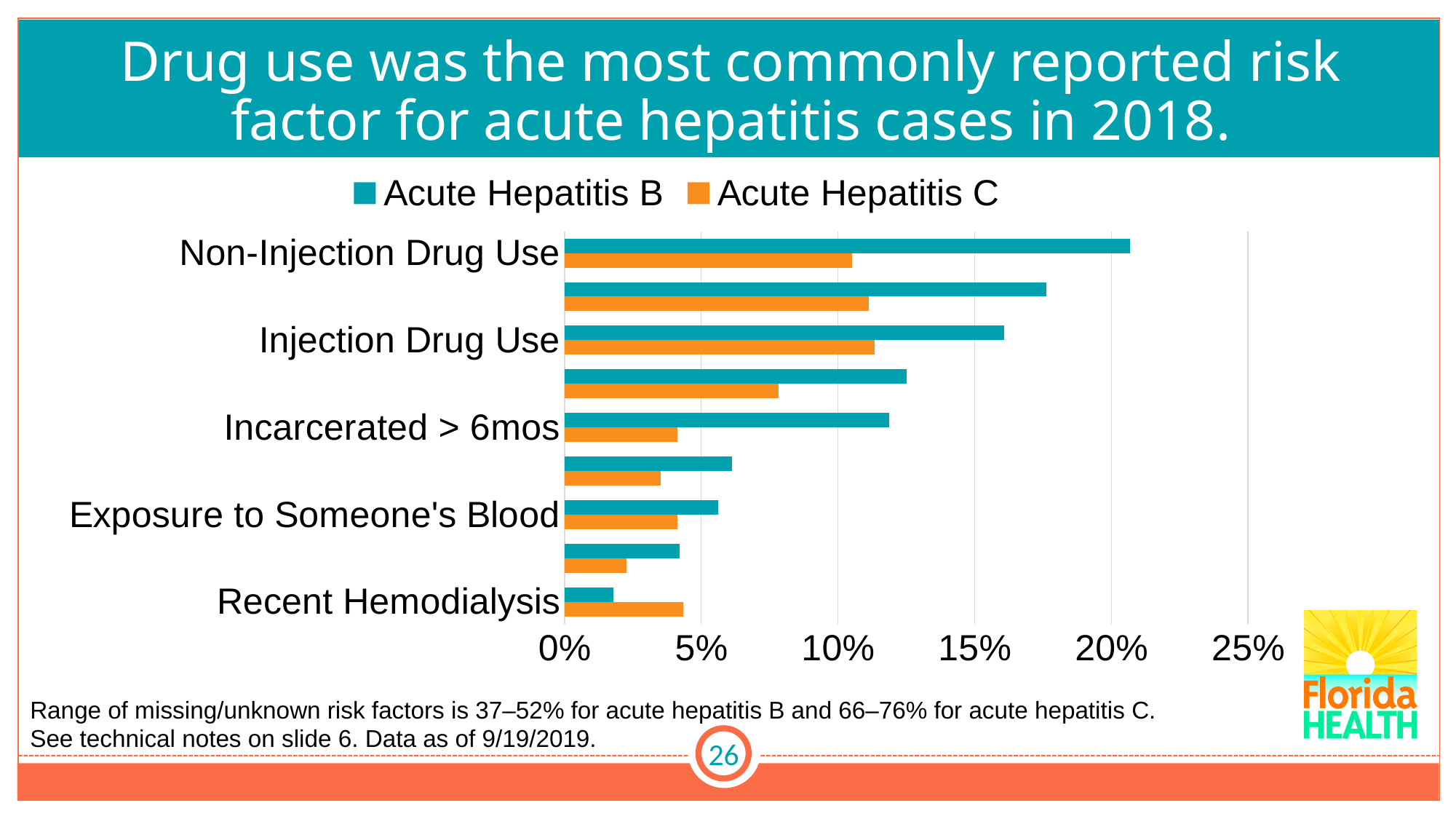
Among the labeled risk factors, which has the lowest value for Acute Hepatitis B? Recent Hemodialysis What kind of chart is shown on the slide? bar chart Is the Acute Hepatitis B value for Injection Drug Use greater or less than 15%? greater Which two series are listed in the legend? Acute Hepatitis B and Acute Hepatitis C Among the labeled risk factors, which has the highest value for Acute Hepatitis B? Non-Injection Drug Use Is the Acute Hepatitis B value for Recent Hemodialysis greater or less than 5%? less For Recent Hemodialysis, which series has the larger value, Acute Hepatitis B or Acute Hepatitis C? Acute Hepatitis C For Non-Injection Drug Use, which series has the larger value, Acute Hepatitis B or Acute Hepatitis C? Acute Hepatitis B Is the Acute Hepatitis C value for Injection Drug Use greater or less than 10%? greater Which colour represents Acute Hepatitis C in the chart? orange How many series does the legend list? 2